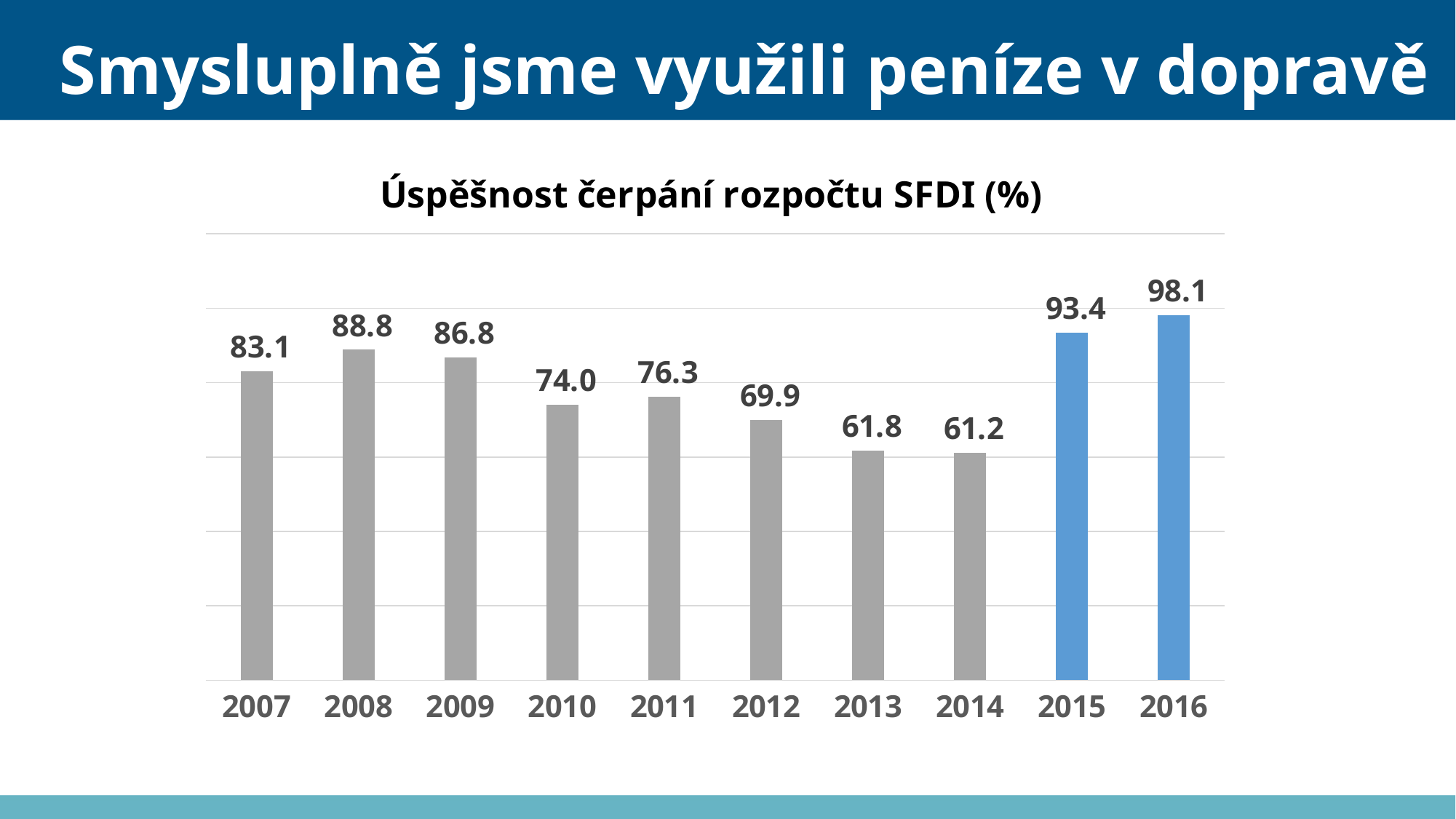
What is the value for 2013? 61.8 What kind of chart is this? bar chart What is the difference between the values for 2008 and 2014? 27.6 How many years are shown on the x axis? 10 What is the value for 2010? 74.0 What is the value for 2016? 98.1 What is the title of the chart? Úspěšnost čerpání rozpočtu SFDI (%) Which year has the highest value? 2016 What is the difference between the values for 2016 and 2015? 4.7 Which is larger, the value for 2009 or the value for 2011? 2009 Which years are shown with blue bars instead of grey? 2015 and 2016 Which year has the lowest value? 2014